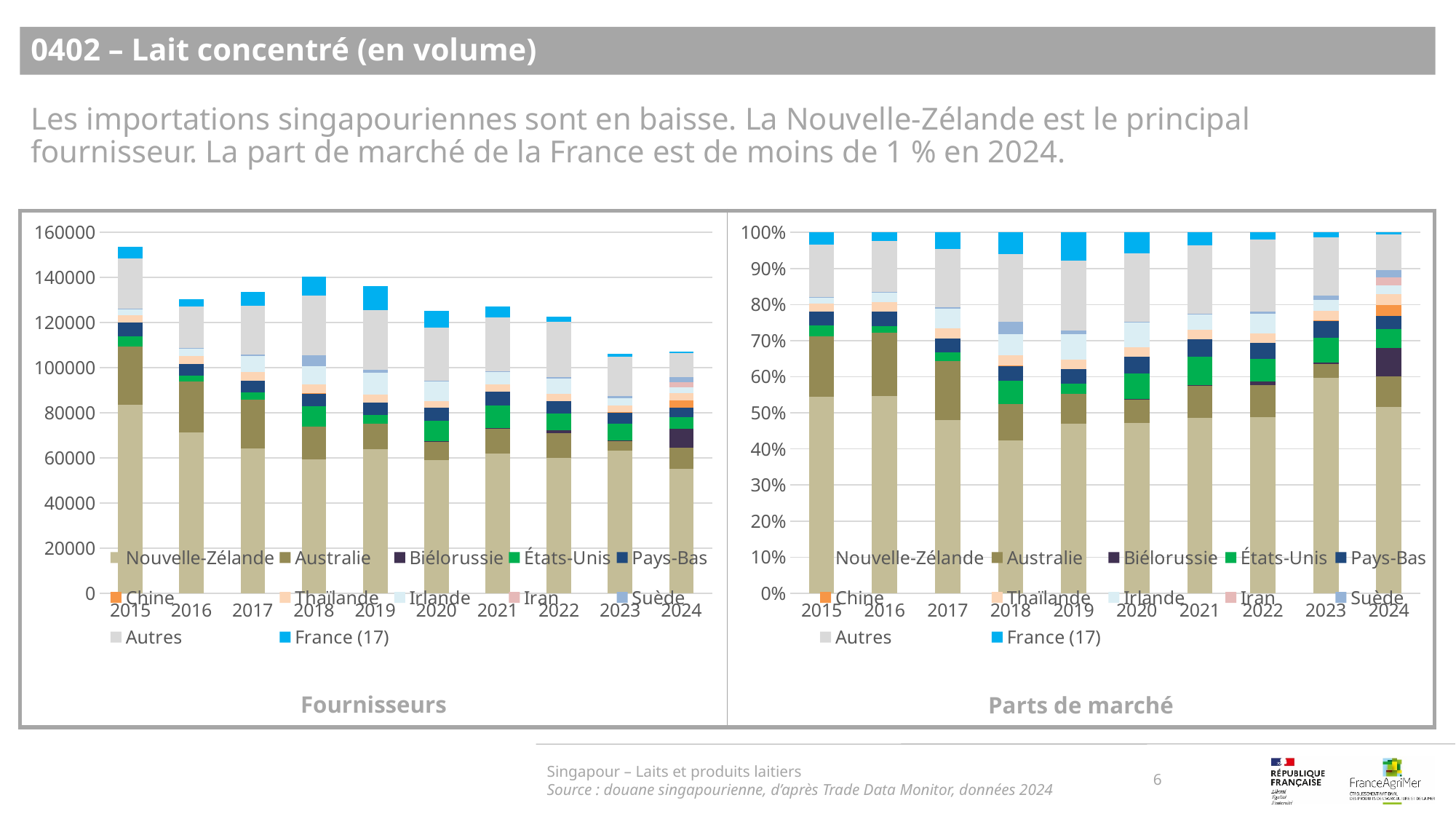
In the 'Parts de marché' chart, is the Nouvelle-Zélande share for 2018 greater or less than 50%? less In the 'Fournisseurs' chart, is the total for 2024 greater or less than 120000? less How many series does the legend of the 'Fournisseurs' chart list? 12 In the 'Fournisseurs' chart, is the Nouvelle-Zélande value for 2020 greater or less than 80000? less In the 'Fournisseurs' chart, which year has the highest total bar? 2015 What is the title of the chart on the right of the slide? Parts de marché In the 'Parts de marché' chart, which series has the largest share in 2024? Nouvelle-Zélande How many years are shown on the x axis of the 'Parts de marché' chart? 10 What kind of chart is the 'Fournisseurs' chart on the left? Stacked bar chart In the 'Fournisseurs' chart, do the total bars generally rise or fall from 2015 to 2024? fall